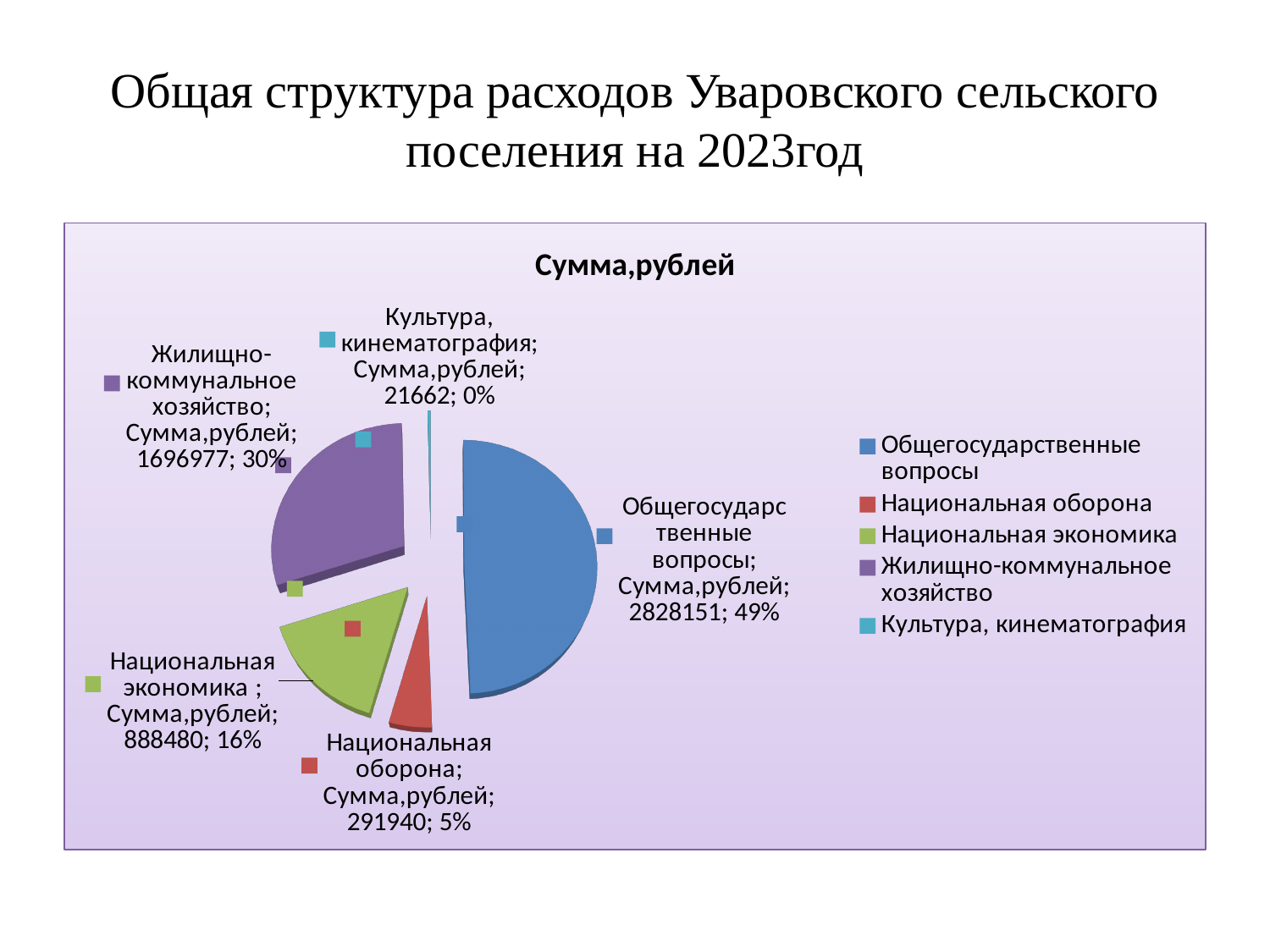
How many categories does the legend list? 5 What is the value for Жилищно-коммунальное хозяйство? 1696977 What share of the pie does Национальная экономика represent? 16% What kind of chart is shown on the slide? pie chart What share of the pie does Жилищно-коммунальное хозяйство represent? 30% Which category has the largest slice? Общегосударственные вопросы What is the value for Национальная оборона? 291940 What is the difference between the values for Общегосударственные вопросы and Жилищно-коммунальное хозяйство? 1131174 Which category has the smallest slice? Культура, кинематография What is the value for Общегосударственные вопросы? 2828151 What is the value for Национальная экономика? 888480 What is the value for Культура, кинематография? 21662